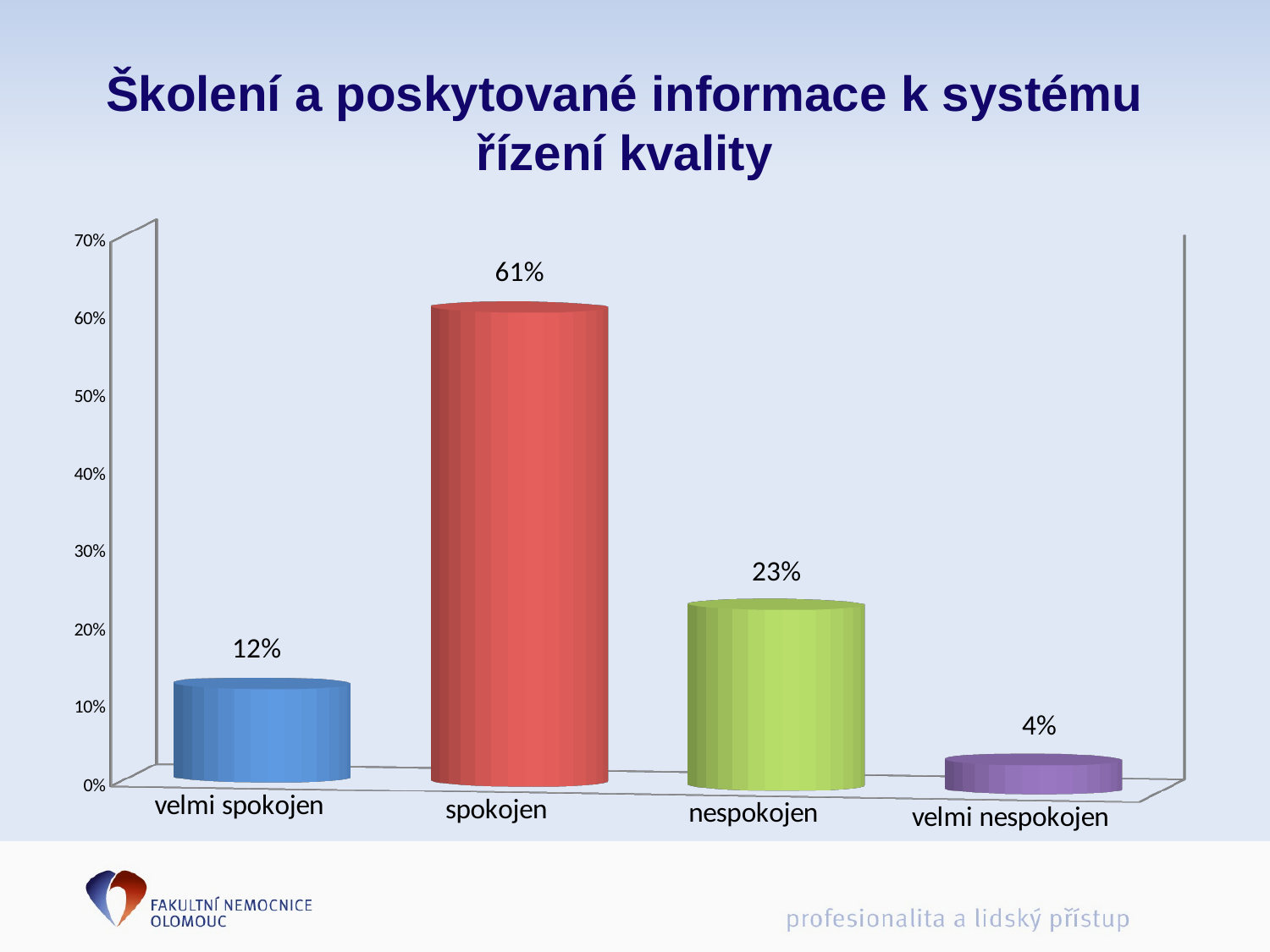
What kind of chart is shown on the slide? bar chart What is the difference between the values for "spokojen" and "nespokojen"? 38% Which category has the highest value? spokojen What is the value for "spokojen"? 61% Which is larger, the value for "velmi spokojen" or the value for "nespokojen"? nespokojen Which category has the lowest value? velmi nespokojen What is the title of the slide? Školení a poskytované informace k systému řízení kvality What is the value for "nespokojen"? 23% What is the value for "velmi nespokojen"? 4% How many categories are shown on the x axis? 4 Is the value for "spokojen" greater or less than 50%? greater What is the value for "velmi spokojen"? 12%